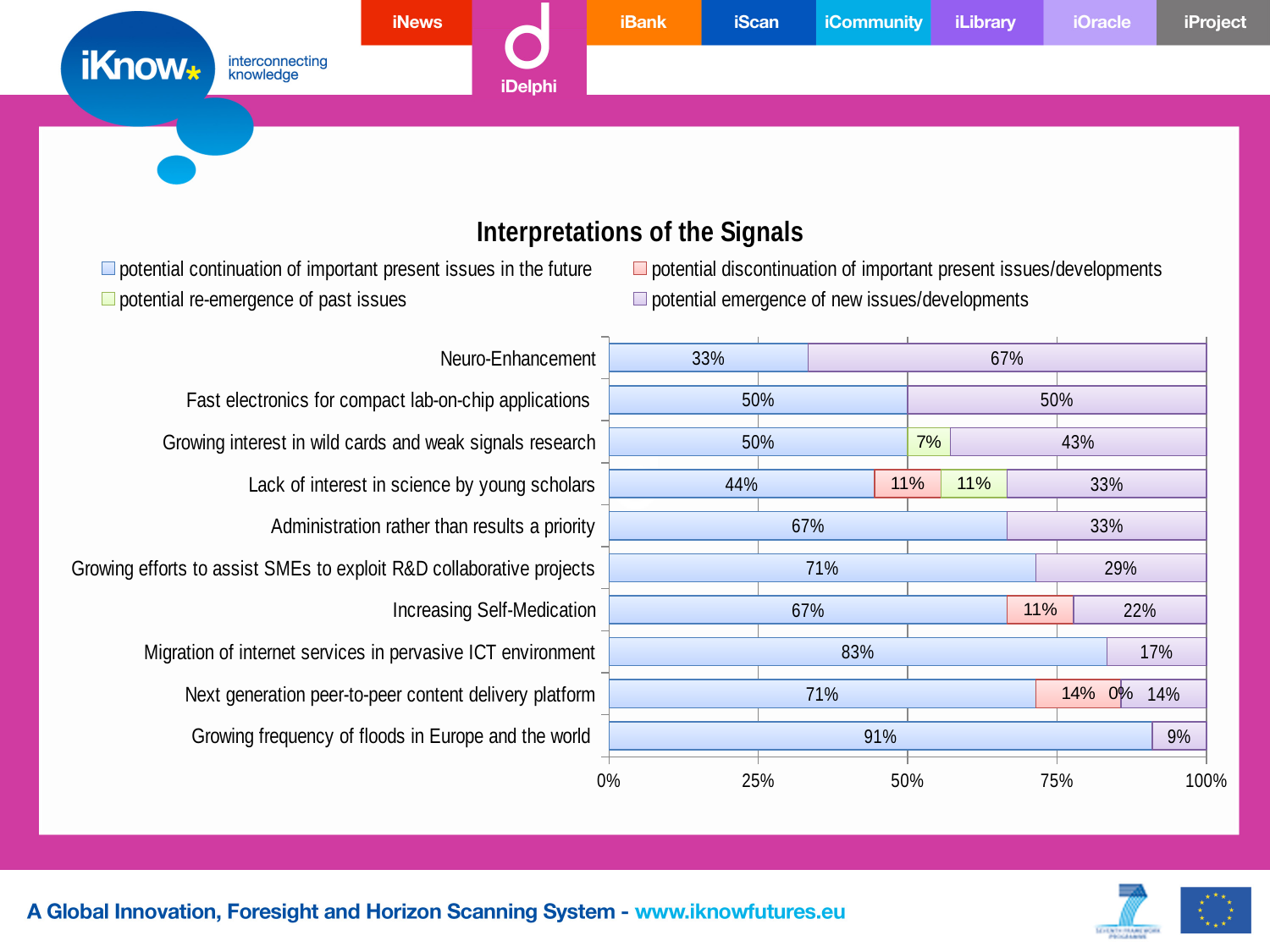
Which has a larger 'potential emergence of new issues/developments' value: Neuro-Enhancement or Lack of interest in science by young scholars? Neuro-Enhancement What is the title of the chart? Interpretations of the Signals What is the value for 'potential re-emergence of past issues' for Next generation peer-to-peer content delivery platform? 0% Which signal has the highest value for 'potential continuation of important present issues in the future'? Growing frequency of floods in Europe and the world What is the value for 'potential emergence of new issues/developments' for Growing interest in wild cards and weak signals research? 43% How many signals (categories) are plotted in the chart? 10 What kind of chart is shown on the slide? stacked bar chart What is the value for 'potential continuation of important present issues in the future' for Neuro-Enhancement? 33% Which signal has the lowest value for 'potential continuation of important present issues in the future'? Neuro-Enhancement How many series does the legend list? 4 What is the difference between the 'potential continuation' values for Migration of internet services in pervasive ICT environment and Administration rather than results a priority? 16% What is the value for 'potential discontinuation of important present issues/developments' for Increasing Self-Medication? 11%